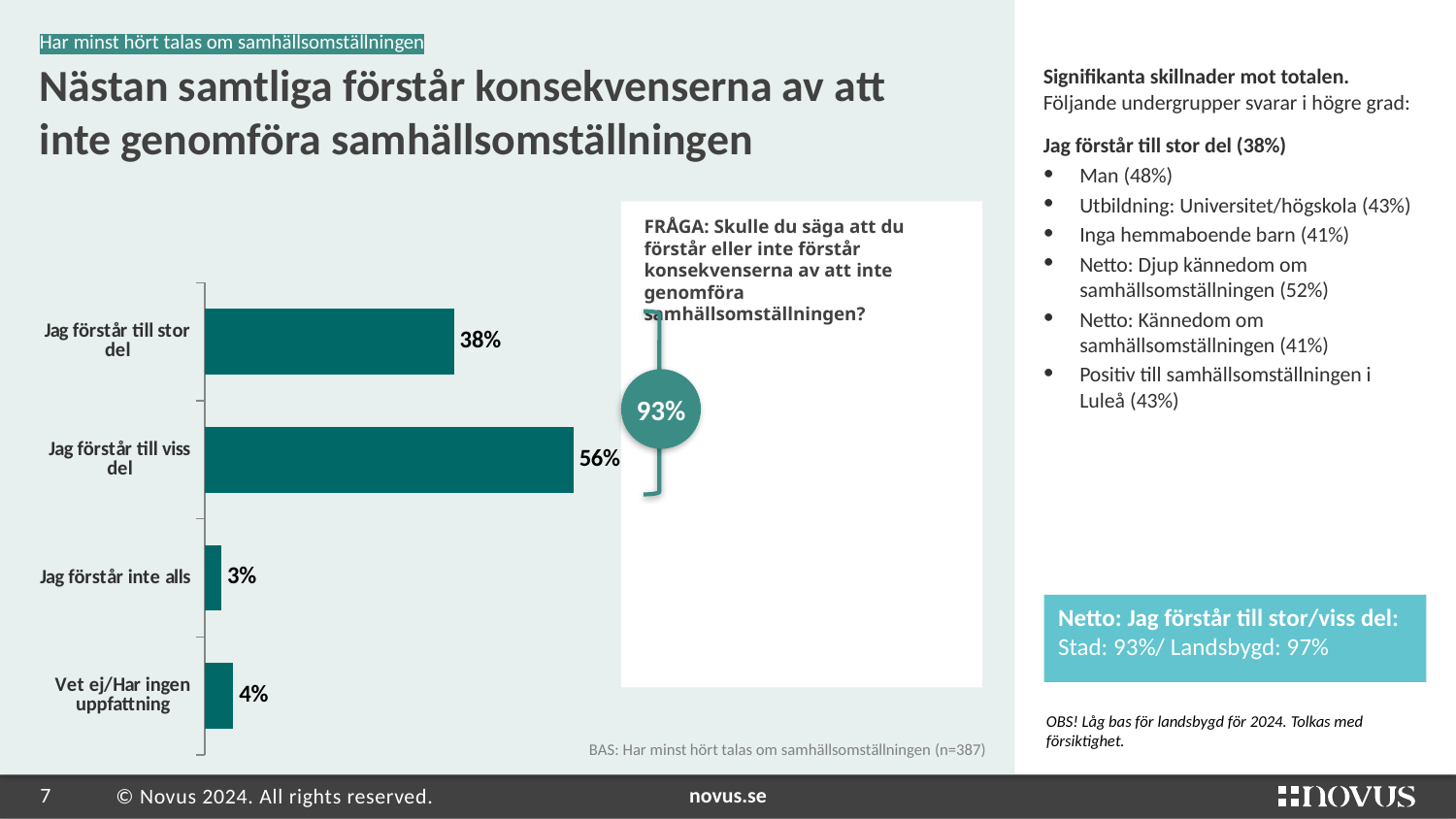
What is the value for "Jag förstår inte alls"? 3% What is the difference between "Jag förstår till viss del" and "Jag förstår till stor del"? 18 percentage points Which category has the highest value? Jag förstår till viss del Which is larger: "Vet ej/Har ingen uppfattning" or "Jag förstår inte alls"? Vet ej/Har ingen uppfattning What kind of chart is shown on the slide? Bar chart What is the value for "Jag förstår till viss del"? 56% What is the base (n) stated below the chart? n=387 What is the combined value of "Jag förstår till stor del" and "Jag förstår till viss del" shown in the circle next to the chart? 93% What is the value for "Jag förstår till stor del"? 38% What is the value for "Vet ej/Har ingen uppfattning"? 4% How many categories are shown in the bar chart? 4 Which category has the lowest value? Jag förstår inte alls